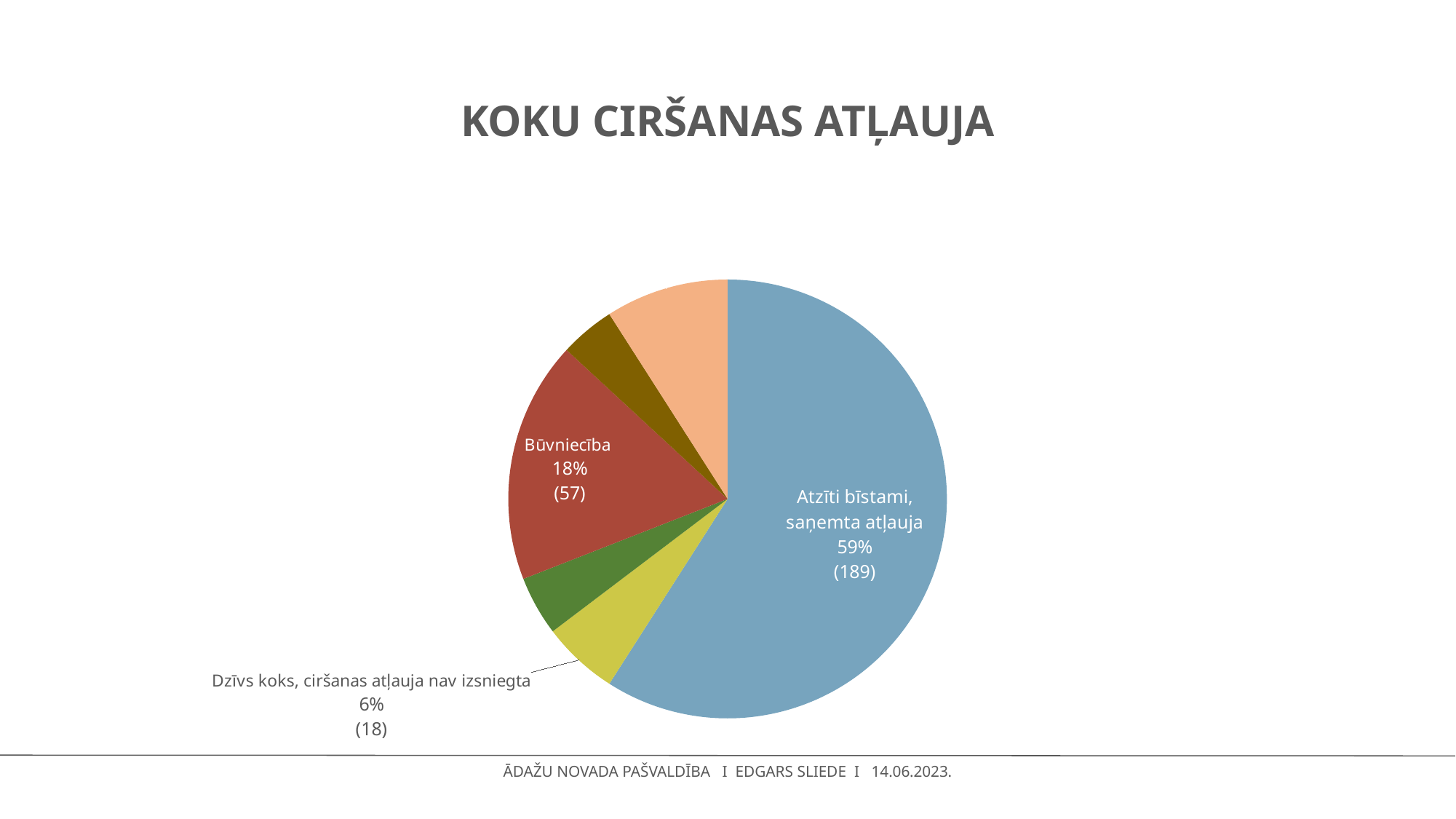
How many slices does the pie chart have? 6 Which is larger: the slice for "Būvniecība" or the slice for "Dzīvs koks, ciršanas atļauja nav izsniegta"? Būvniecība How many cases are shown for "Atzīti bīstami, saņemta atļauja"? 189 Which category has the largest slice of the pie? Atzīti bīstami, saņemta atļauja What percentage of the pie does "Būvniecība" represent? 18% How many cases are shown for "Būvniecība"? 57 How many cases are shown for "Dzīvs koks, ciršanas atļauja nav izsniegta"? 18 What percentage of the pie does "Atzīti bīstami, saņemta atļauja" represent? 59% What is the difference in the number of cases between "Atzīti bīstami, saņemta atļauja" and "Būvniecība"? 132 What kind of chart is shown on the slide? pie chart What is the title of the chart? KOKU CIRŠANAS ATĻAUJA What percentage of the pie does "Dzīvs koks, ciršanas atļauja nav izsniegta" represent? 6%